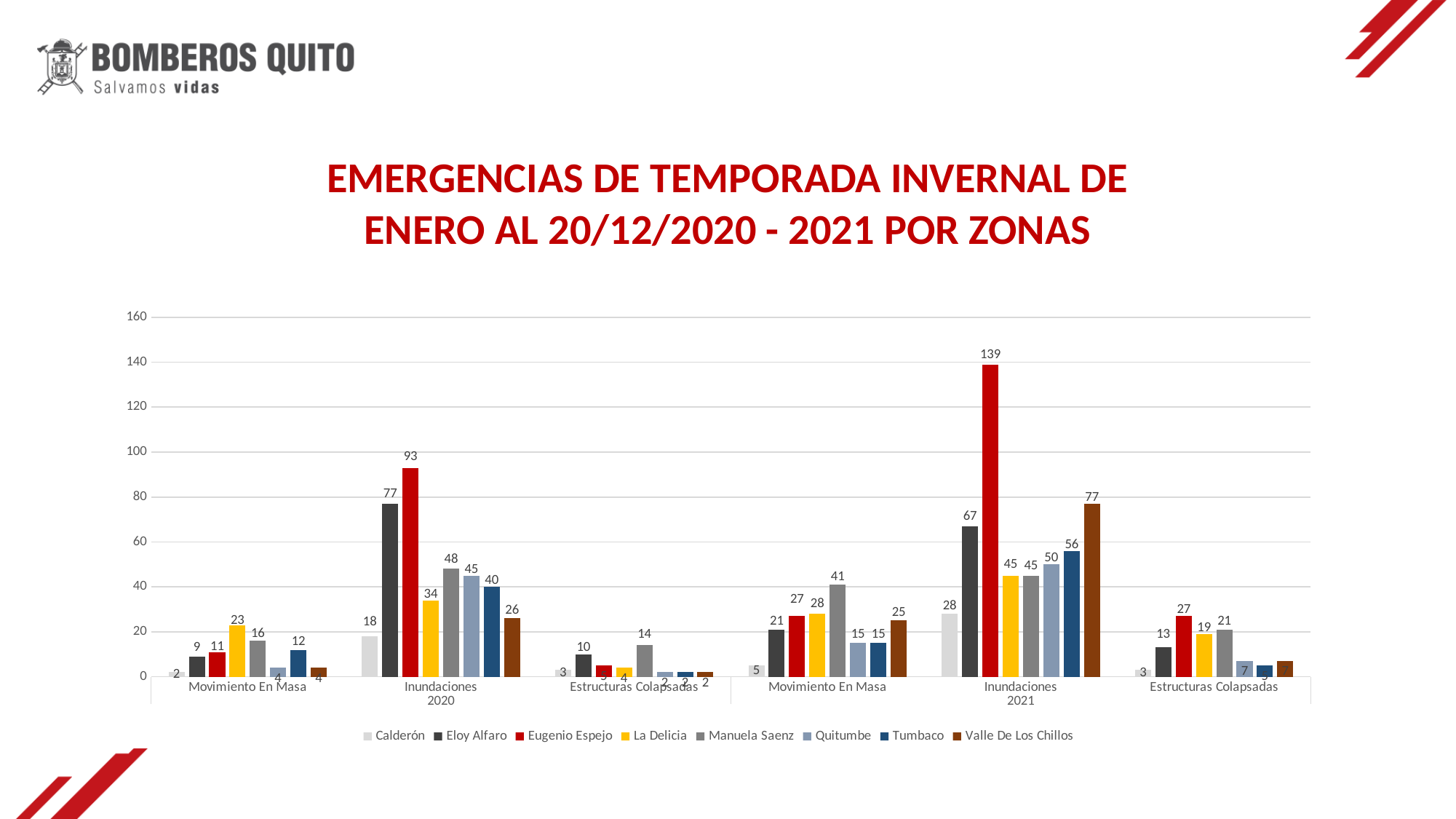
Which zone has the highest value in Inundaciones 2021? Eugenio Espejo What is the difference between Eugenio Espejo's values for Inundaciones in 2021 and 2020? 46 Is the value for Eugenio Espejo in Inundaciones 2020 greater or less than 80? greater What is the value for La Delicia in Movimiento En Masa 2020? 23 What is the value for Manuela Saenz in Movimiento En Masa 2021? 41 What is the value for Eloy Alfaro in Inundaciones 2020? 77 Which is larger in Inundaciones 2021: Valle De Los Chillos or Eloy Alfaro? Valle De Los Chillos Which colour represents Eugenio Espejo in the legend? Red Which zone has the lowest value in Movimiento En Masa 2021? Calderón What kind of chart is shown on the slide? Bar chart What is the value for Eugenio Espejo in Inundaciones 2021? 139 How many series does the legend list? 8